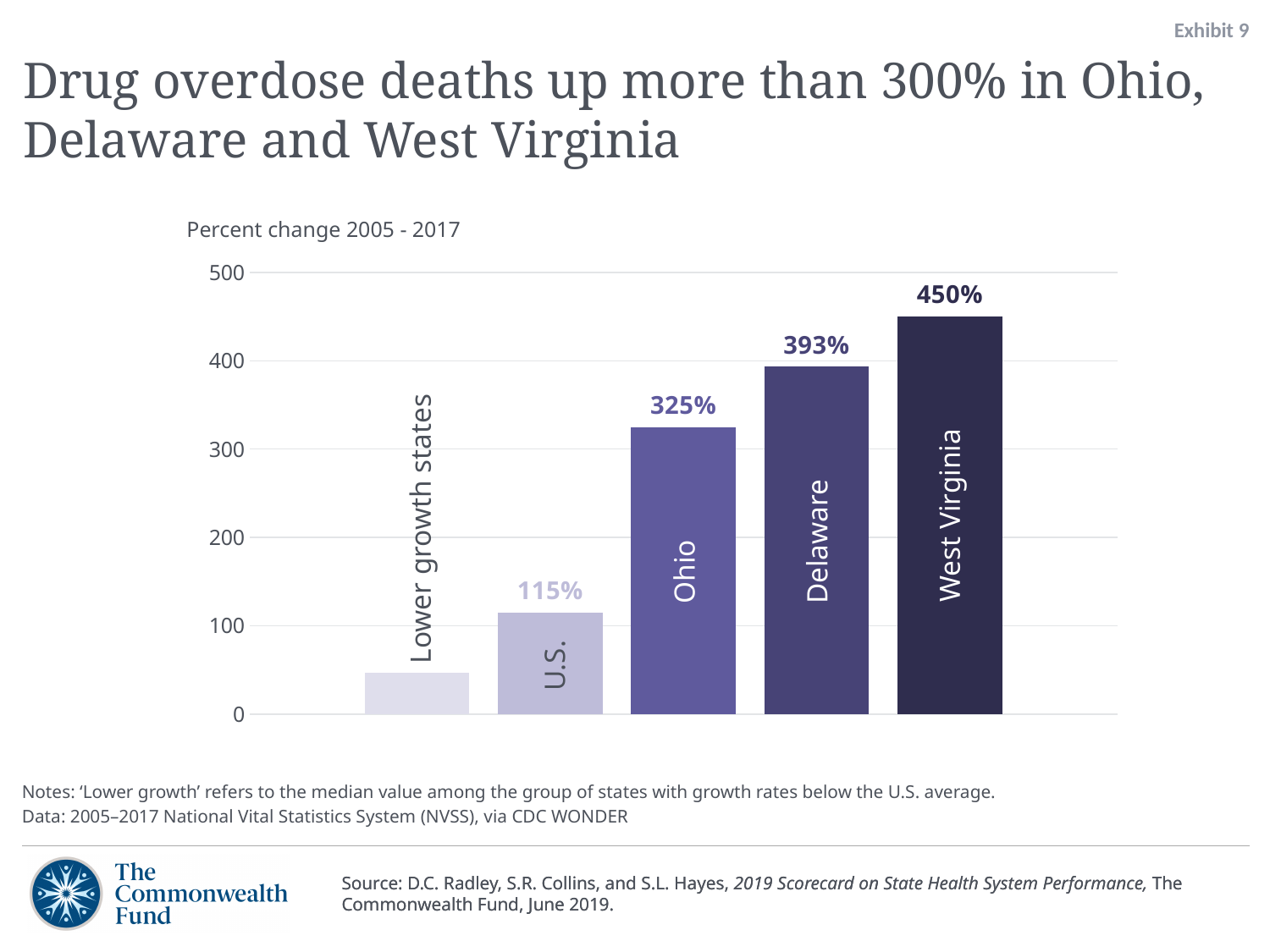
Which category has the lowest percent change? Lower growth states What is the difference in percent change between Delaware and the U.S.? 278 percentage points Which has a larger percent change, Delaware or Ohio? Delaware What is the percent change in drug overdose deaths for Ohio? 325% What is the difference in percent change between West Virginia and Ohio? 125 percentage points Which category has the highest percent change? West Virginia What kind of chart is shown on the slide? Bar chart What is the percent change in drug overdose deaths for West Virginia? 450% Is the value for Lower growth states greater or less than 100? less What is the percent change in drug overdose deaths for Delaware? 393% How many categories are shown in the chart? 5 What is the percent change in drug overdose deaths for the U.S.? 115%